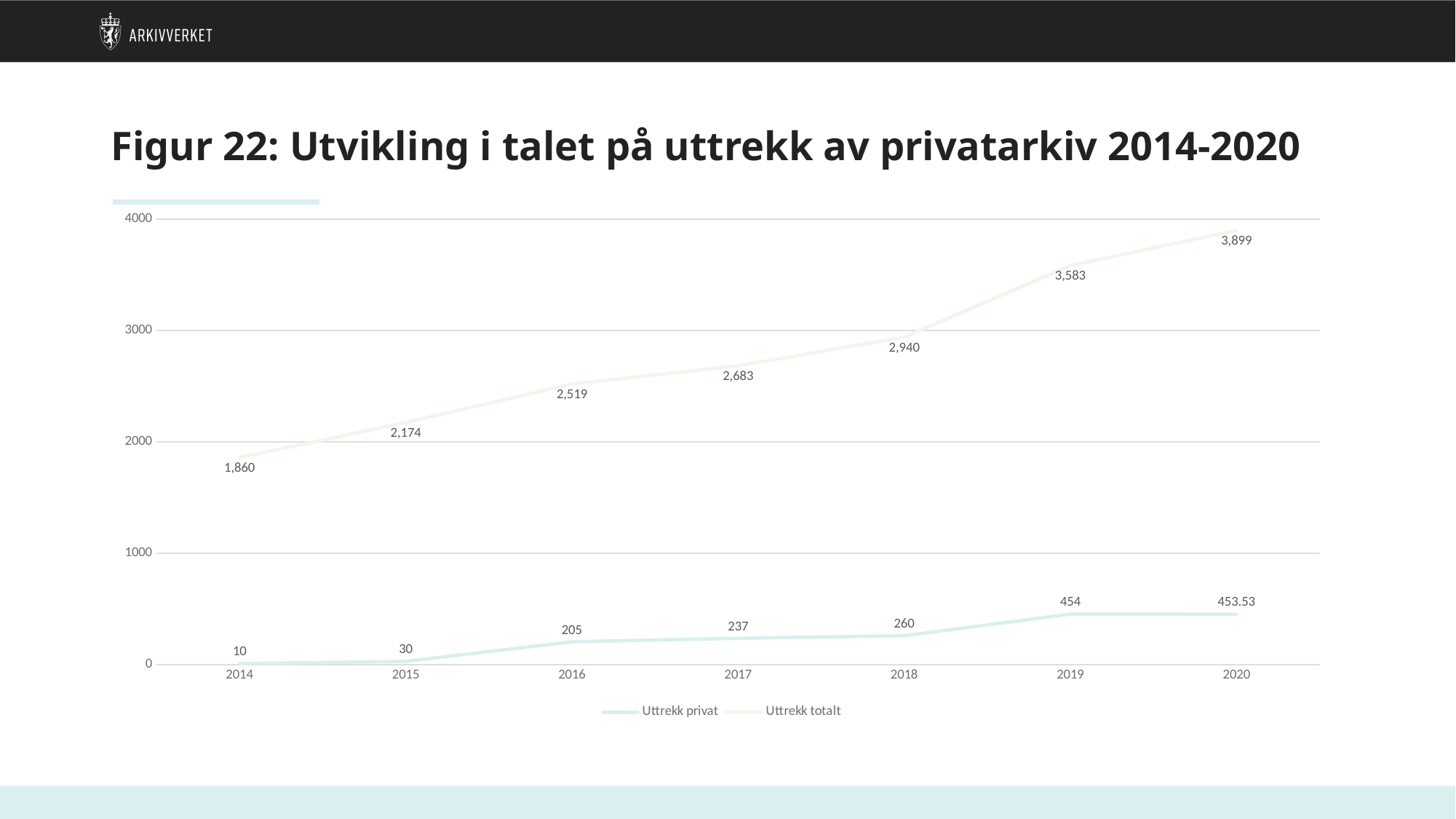
How many years are shown on the x axis? 7 What is the difference between Uttrekk totalt in 2019 and 2018? 643 What is the value of Uttrekk totalt in 2020? 3,899 What is the value of Uttrekk totalt in 2014? 1,860 What kind of chart is shown on the slide? Line chart In which year is Uttrekk privat lowest? 2014 How many series does the legend list? 2 What is the value of Uttrekk privat in 2020? 453.53 Which is larger: Uttrekk privat in 2017 or in 2018? 2018 Does Uttrekk totalt rise or fall from 2014 to 2020? Rise In which year is Uttrekk totalt highest? 2020 What is the value of Uttrekk privat in 2016? 205